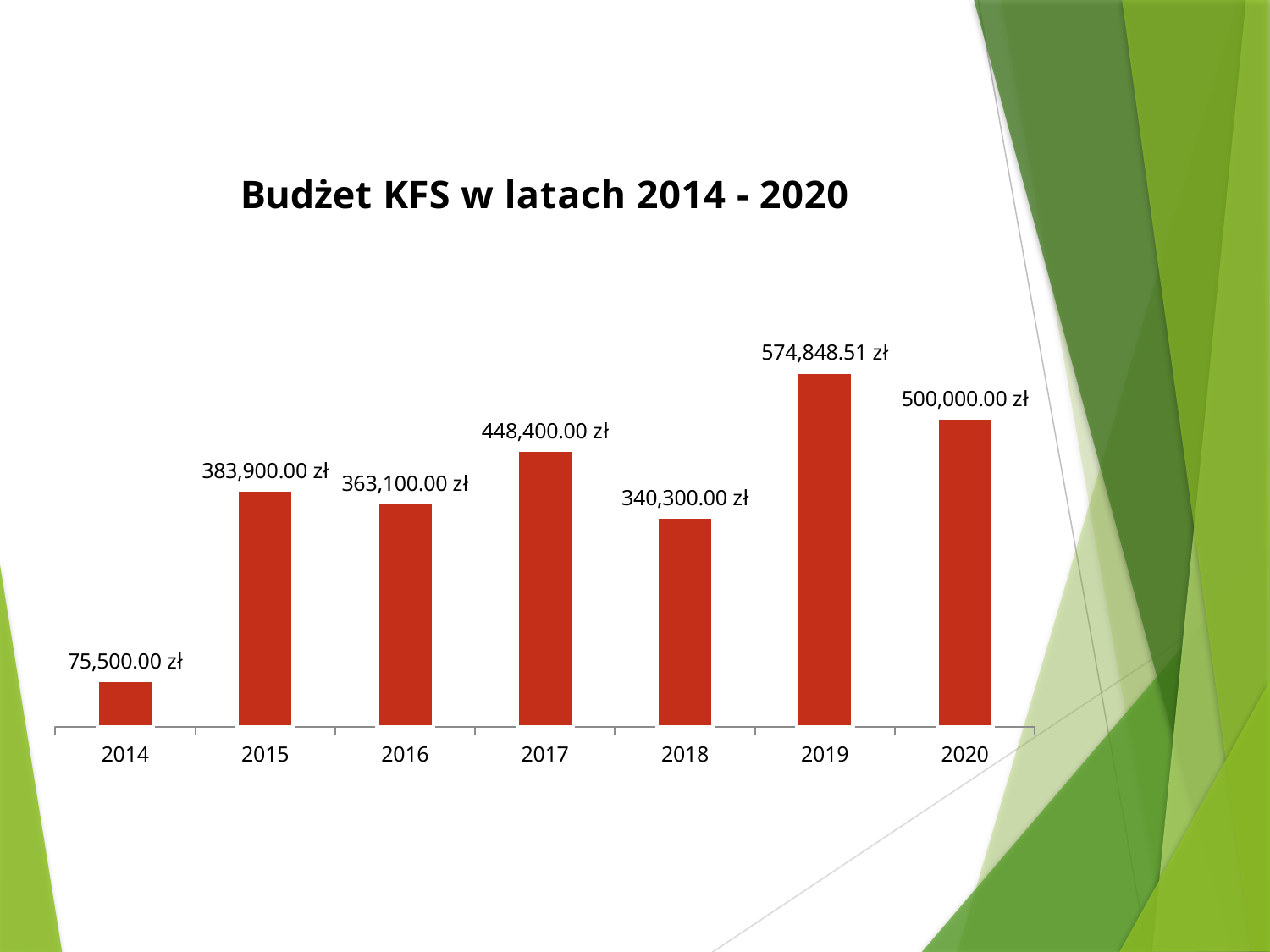
What is the title of the chart? Budżet KFS w latach 2014 - 2020 Which year has a larger KFS budget, 2017 or 2018? 2017 What is the KFS budget value shown for 2020? 500,000.00 zł What is the KFS budget value shown for 2014? 75,500.00 zł What is the KFS budget value shown for 2017? 448,400.00 zł Which year has the lowest KFS budget? 2014 Which year has the highest KFS budget? 2019 What is the difference between the KFS budget in 2019 and in 2020? 74,848.51 zł What is the KFS budget value shown for 2019? 574,848.51 zł What is the difference between the KFS budget in 2015 and in 2016? 20,800.00 zł How many years are shown on the chart? 7 What kind of chart is shown on the slide? Bar chart